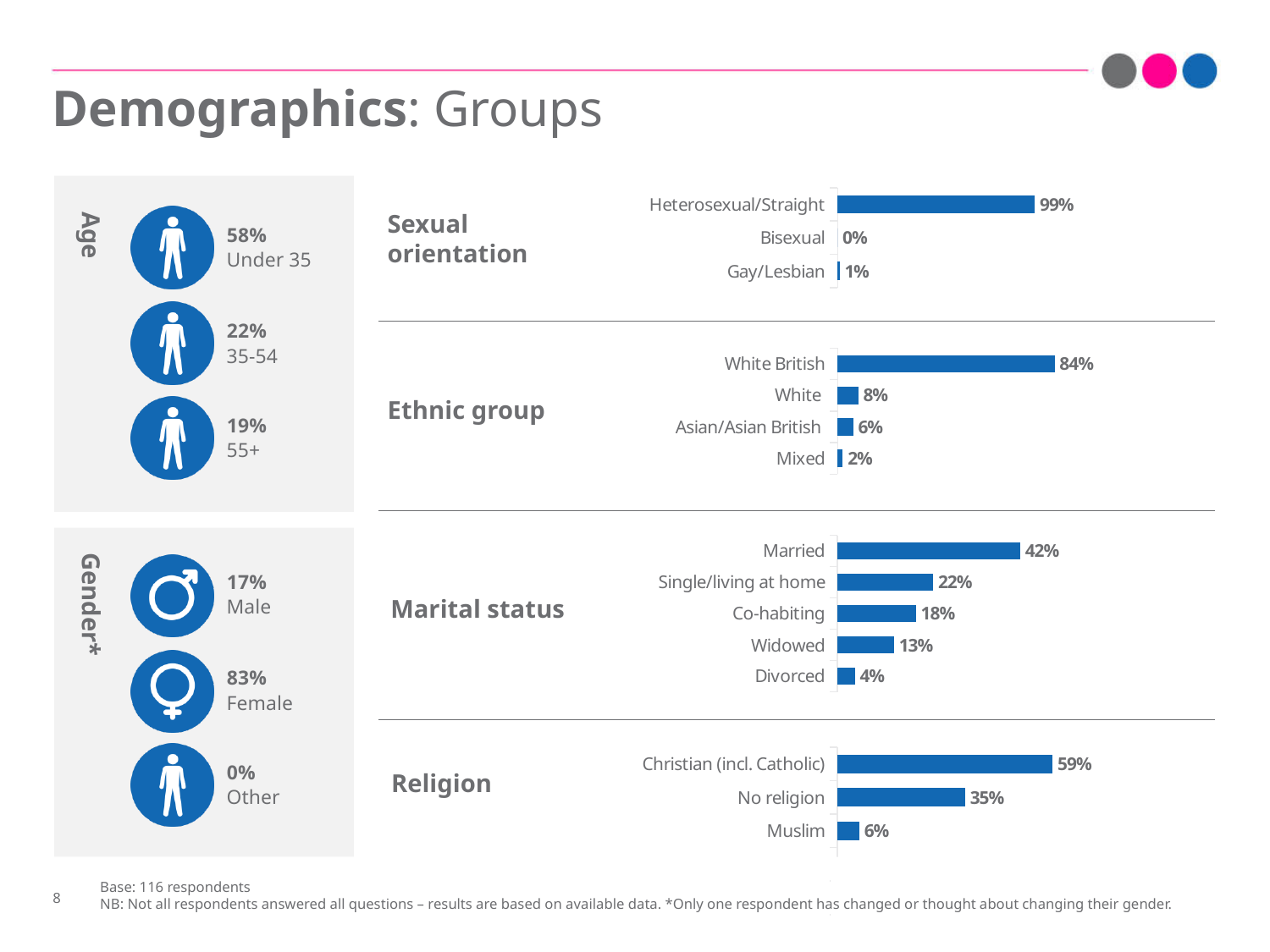
In the Marital status chart, what is the value for Widowed? 13% In the Marital status chart, which category has the highest value? Married What kind of chart is the Religion chart? Bar chart In the Sexual orientation chart, what is the difference between Heterosexual/Straight and Gay/Lesbian? 98% In the Ethnic group chart, what is the value for Asian/Asian British? 6% In the Marital status chart, which category has the lowest value? Divorced In the Ethnic group chart, which is larger, White or Mixed? White How many categories does the Ethnic group chart show? 4 In the Religion chart, what is the difference between Christian (incl. Catholic) and No religion? 24% How many categories does the Marital status chart show? 5 In the Sexual orientation chart, what is the value for Heterosexual/Straight? 99% In the Religion chart, what is the value for Muslim? 6%